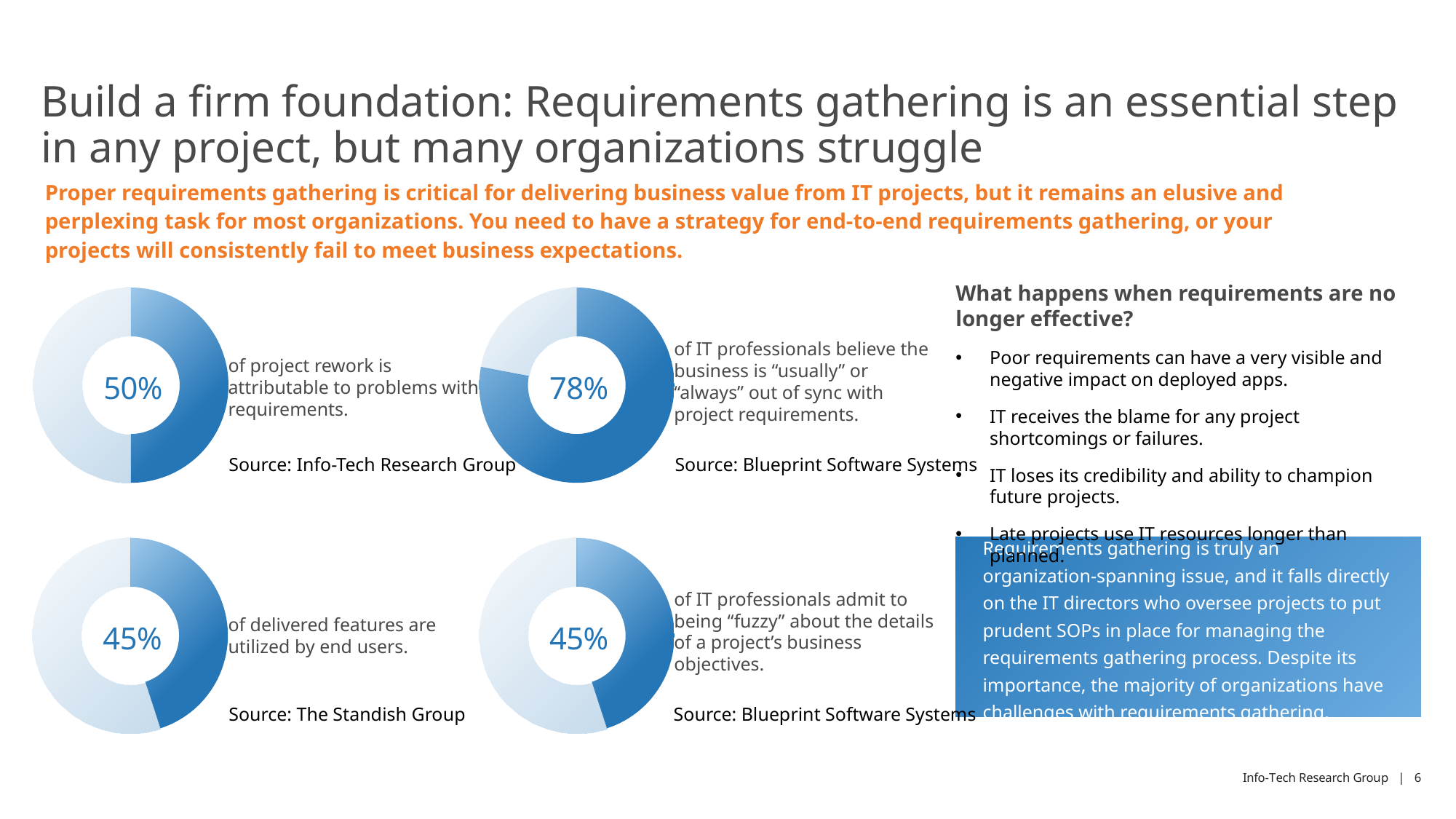
In the top-right donut chart, what share of the ring is filled by the dark blue segment? 78% What is the difference between the percentage in the top-right donut chart (78%) and the top-left donut chart (50%)? 28 percentage points What percentage of delivered features are utilized by end users, according to the bottom-left donut chart? 45% What kind of chart is used to display the four statistics on the slide? Donut chart Which of the four donut charts shows the highest percentage? The top-right chart (78%) How many donut charts are shown on the slide? 4 According to the bottom-right donut chart, what percentage of IT professionals admit to being "fuzzy" about the details of a project's business objectives? 45% According to the top-right donut chart, what percentage of IT professionals believe the business is "usually" or "always" out of sync with project requirements? 78% What percentage is shown in the centre of the top-left donut chart about project rework? 50% What is the source cited for the top-left donut chart about project rework? Info-Tech Research Group Which is larger: the percentage in the top-left donut chart or the percentage in the bottom-left donut chart? The top-left chart (50%) What is the source cited for the bottom-left donut chart about delivered features? The Standish Group